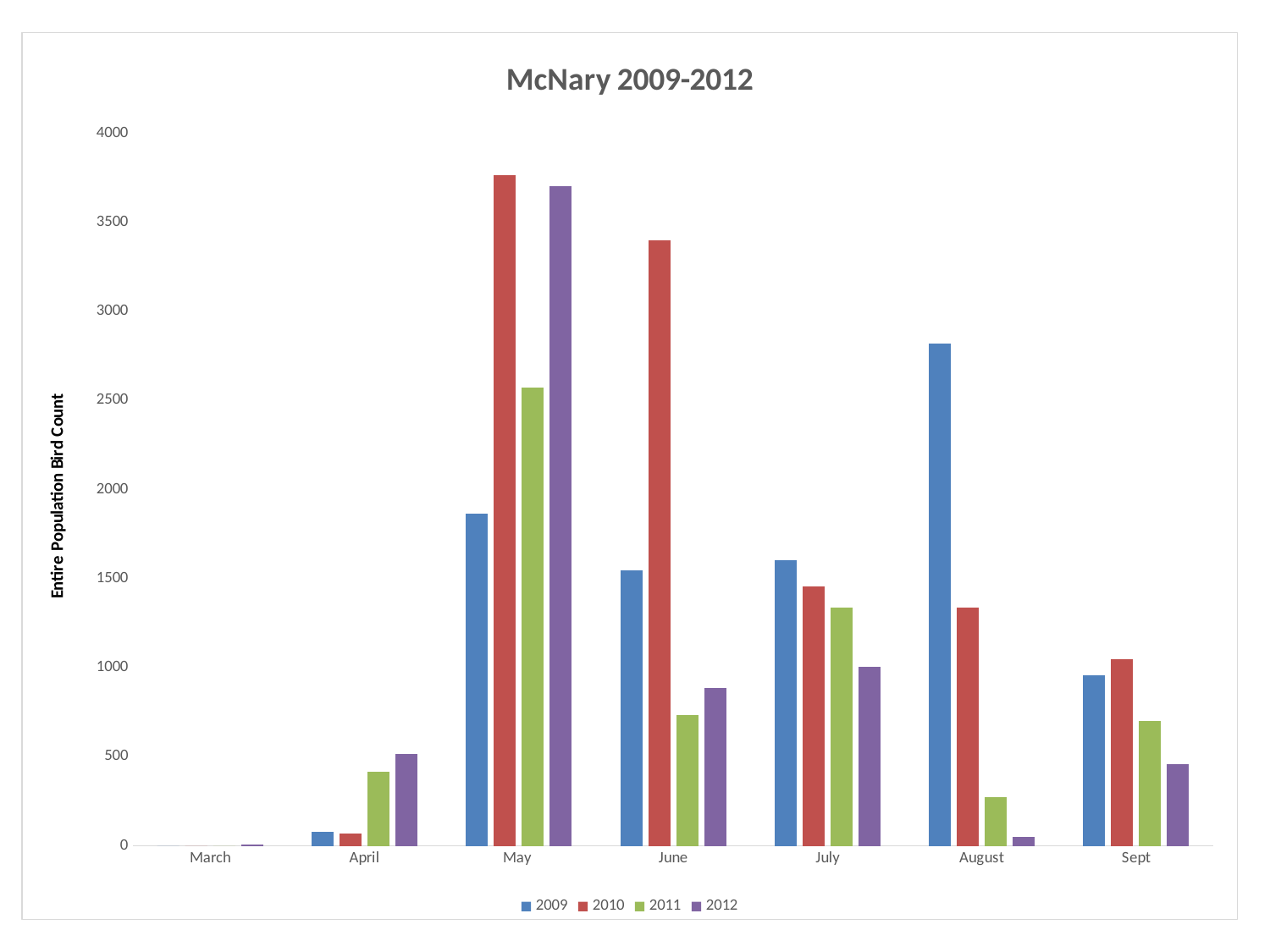
Is the 2010 value for June greater or less than 3000? greater In which month is the 2010 bird count highest? May What kind of chart is shown on the slide? bar chart How many series does the legend list? 4 How many months are shown on the x axis? 7 In which month is the 2012 bird count lowest? March Is the 2011 value for May greater or less than 2000? greater In July, which series has the larger value, 2009 or 2010? 2009 What is the label on the vertical axis? Entire Population Bird Count Do the 2010 values rise or fall from May through August? fall Is the 2009 value for August greater or less than 2500? greater In which month is the 2009 bird count highest? August